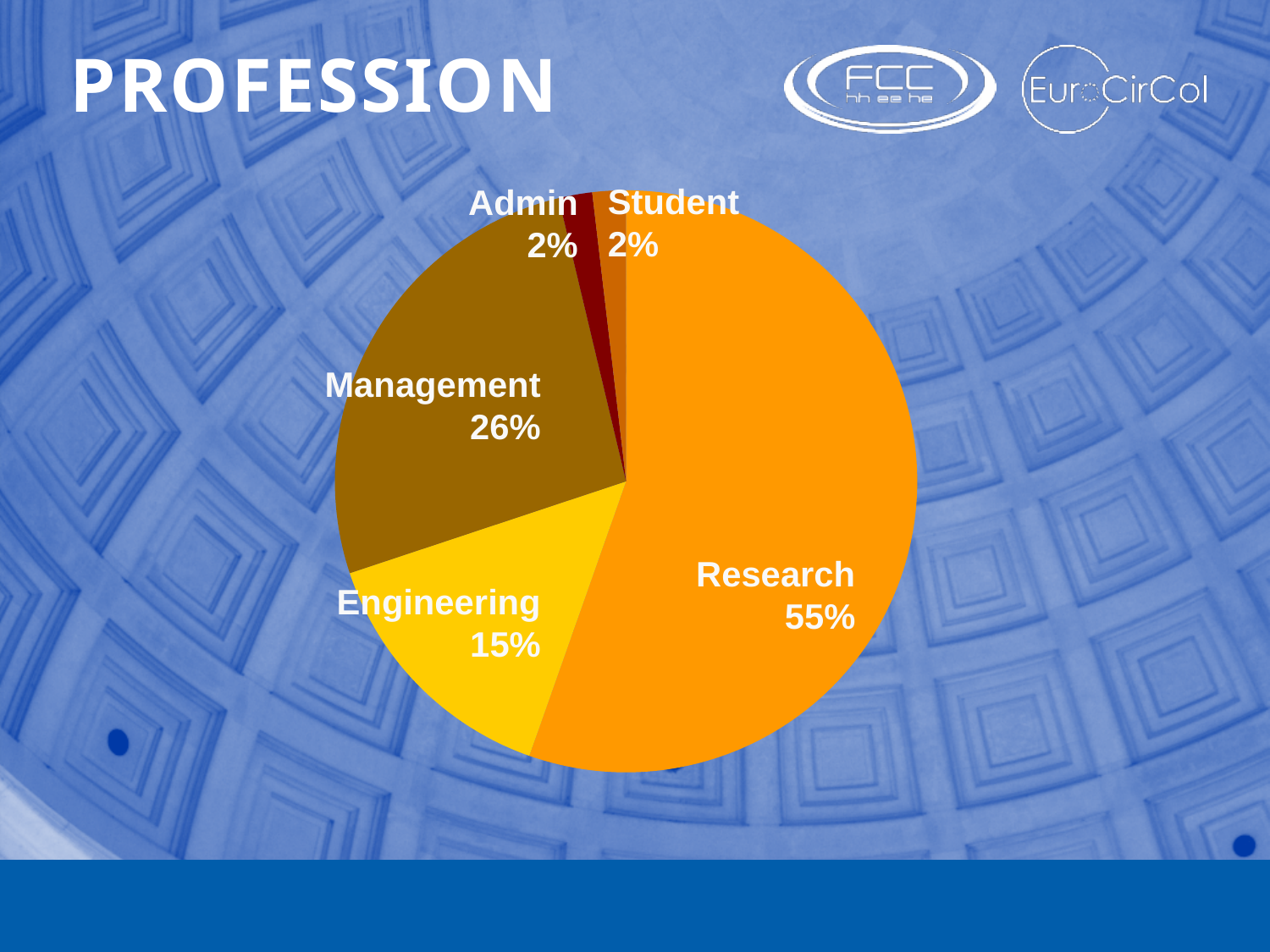
What is the value shown for Engineering? 15% How many slices does the pie chart have? 5 What is the title of the slide containing the pie chart? PROFESSION What is the value shown for Management? 26% What share of the pie does Research account for? 55% What is the difference in percentage points between Management and Engineering? 11 What is the difference in percentage points between Research and Management? 29 Which profession has the largest slice of the pie? Research Which two professions share the same percentage in the pie chart? Admin and Student What is the value shown for Admin? 2% What kind of chart is shown on the slide? pie chart Which is larger, the Management slice or the Engineering slice? Management